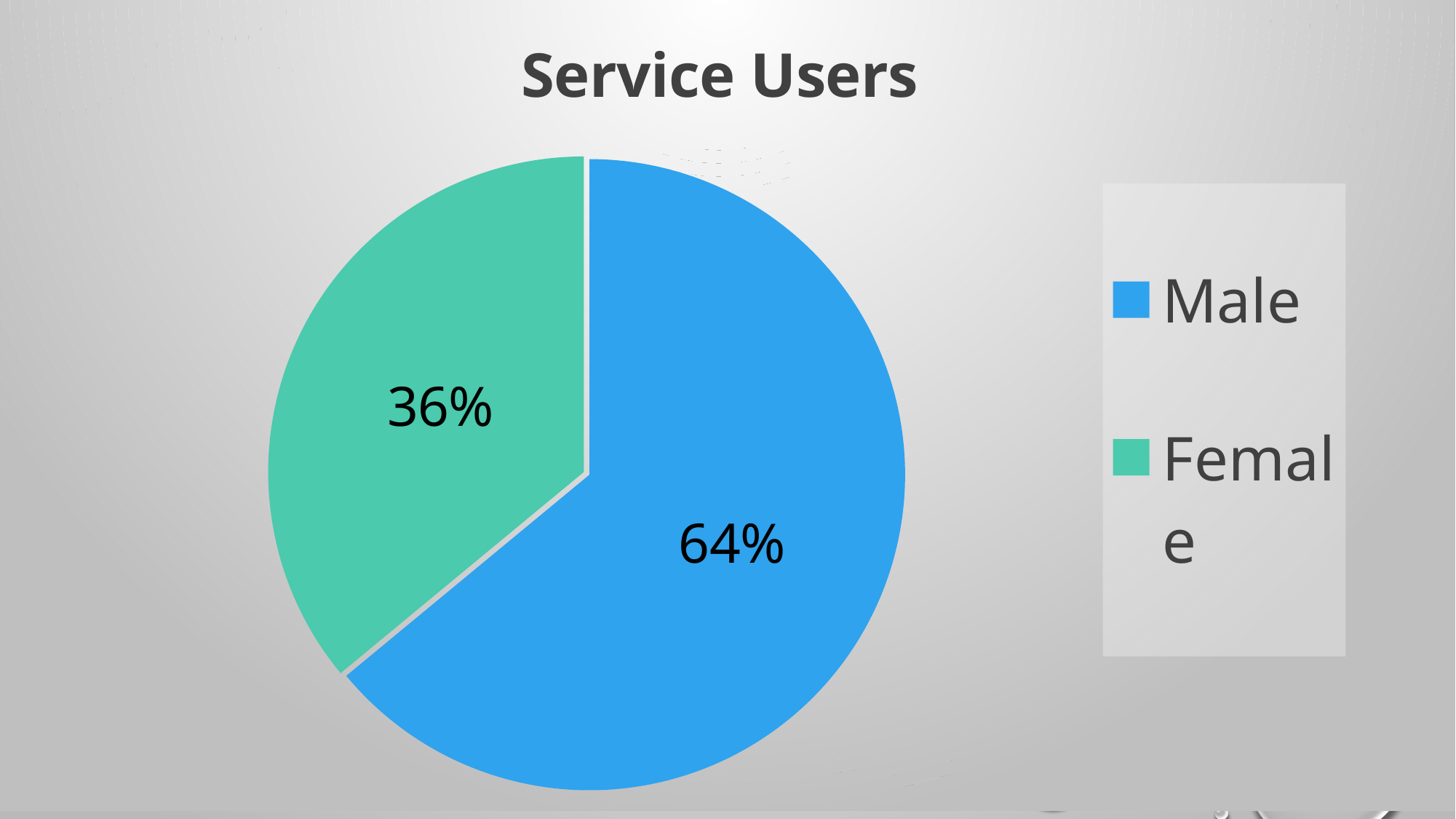
How many slices does the pie chart have? 2 Which is larger, the Male share or the Female share? Male What colour is the Female slice? green What is the difference in percentage points between the Male and Female shares? 28 What kind of chart is shown on the slide? pie chart How many entries does the legend list? 2 What share of service users is Male? 64% Which category has the smallest slice of the pie? Female Which category has the largest slice of the pie? Male What share of service users is Female? 36% What is the title of the chart? Service Users